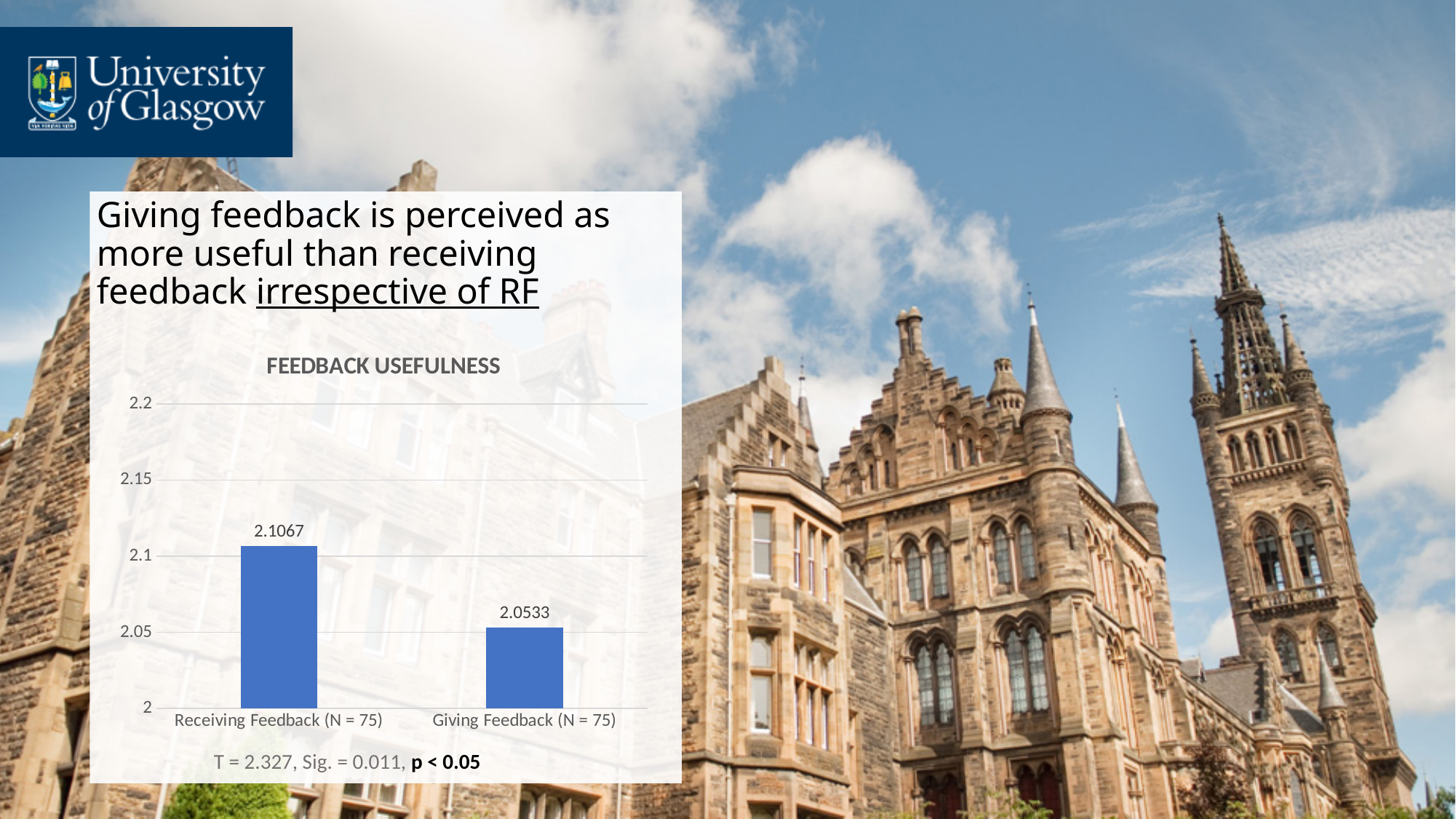
Which category has the highest value in the Feedback Usefulness chart? Receiving Feedback (N = 75) What is the title of the chart on the slide? FEEDBACK USEFULNESS Which category has the lowest value in the Feedback Usefulness chart? Giving Feedback (N = 75) What kind of chart is shown on the slide? bar chart What is the difference between the values for Receiving Feedback (N = 75) and Giving Feedback (N = 75)? 0.0534 What is the value for Giving Feedback (N = 75) in the Feedback Usefulness chart? 2.0533 Is the value for Receiving Feedback (N = 75) greater or less than 2.05? greater What is the T value reported below the chart? 2.327 Which is larger: the value for Receiving Feedback (N = 75) or Giving Feedback (N = 75)? Receiving Feedback (N = 75) How many categories are shown in the Feedback Usefulness chart? 2 Is the value for Giving Feedback (N = 75) greater or less than 2.1? less What is the value for Receiving Feedback (N = 75) in the Feedback Usefulness chart? 2.1067